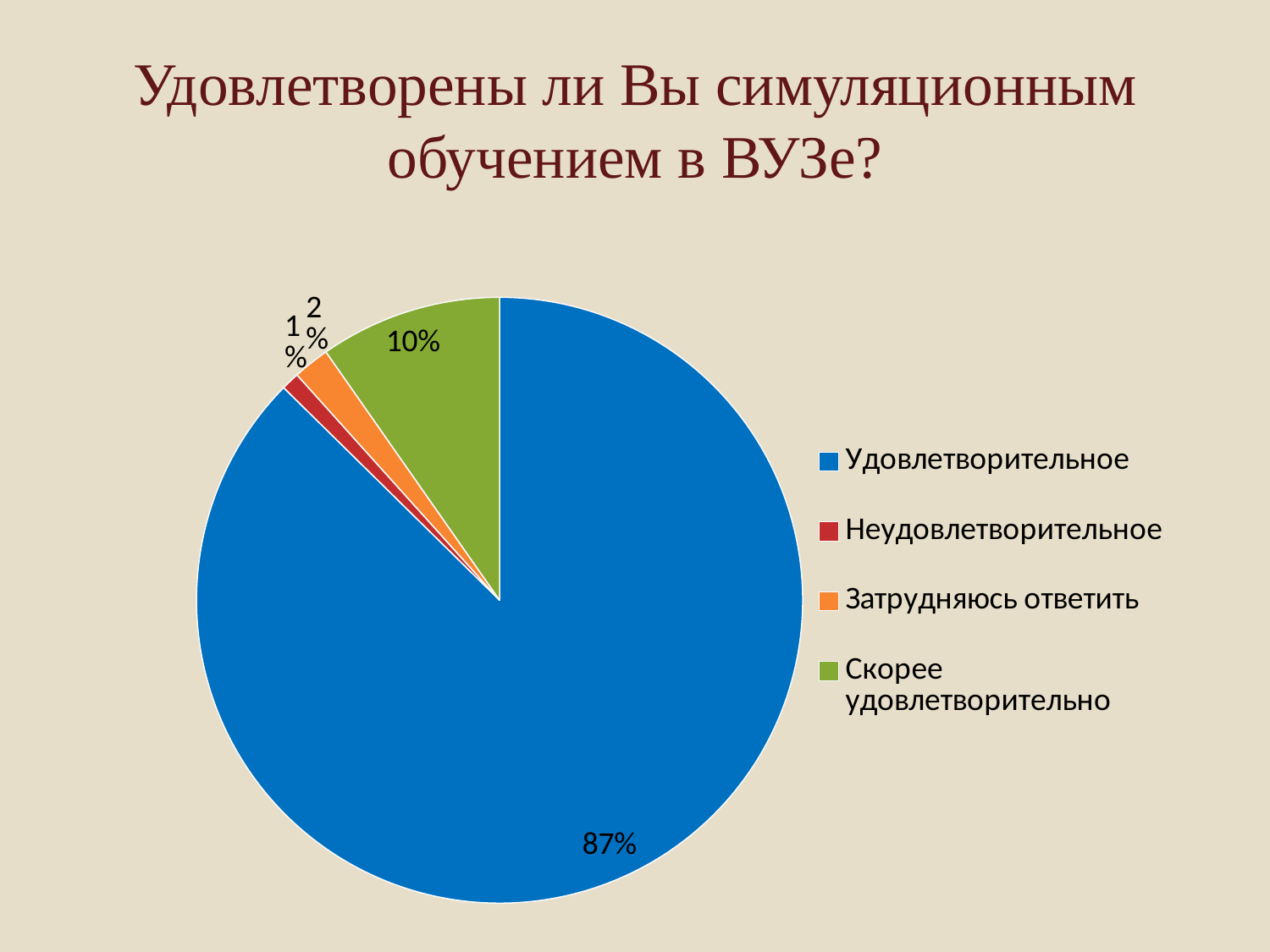
Which is larger, the share for Затрудняюсь ответить or the share for Неудовлетворительное? Затрудняюсь ответить How many categories does the legend list? 4 Which category has the smallest slice of the pie? Неудовлетворительное Which category has the largest slice of the pie? Удовлетворительное What share of the pie is labelled for Удовлетворительное? 87% What share of the pie is labelled for Неудовлетворительное? 1% What is the difference between the shares for Удовлетворительное and Скорее удовлетворительно? 77% What is the title of the chart? Удовлетворены ли Вы симуляционным обучением в ВУЗе? What kind of chart is shown on the slide? pie chart What share of the pie is labelled for Затрудняюсь ответить? 2% What share of the pie is labelled for Скорее удовлетворительно? 10% What colour is the slice for Скорее удовлетворительно? green